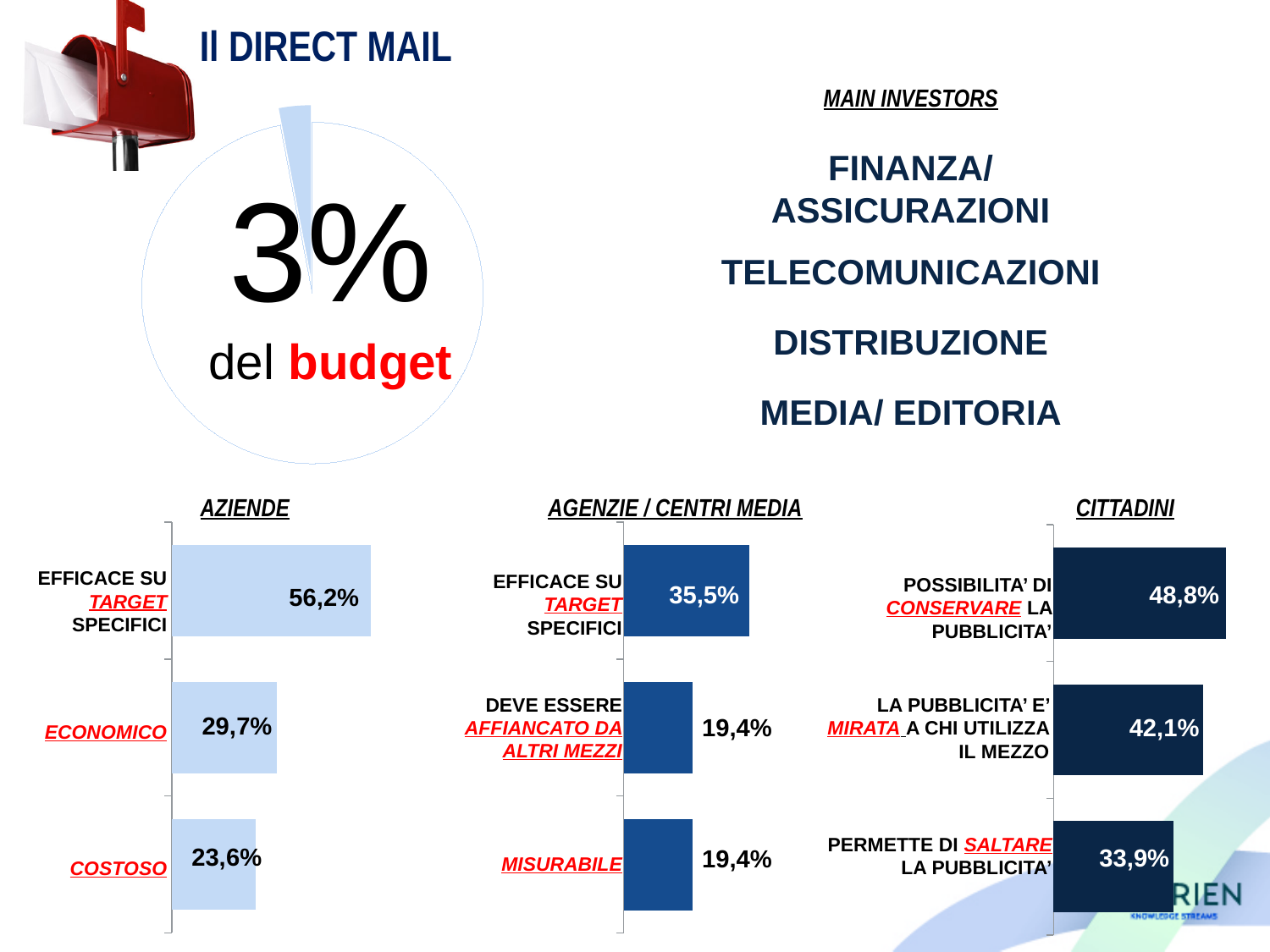
In the AGENZIE / CENTRI MEDIA chart, what is the value for MISURABILE? 19,4% In the CITTADINI chart, which category has the highest value? POSSIBILITA' DI CONSERVARE LA PUBBLICITA' In the AZIENDE chart, what is the difference between EFFICACE SU TARGET SPECIFICI and ECONOMICO? 26,5% In the AZIENDE chart, what is the value for COSTOSO? 23,6% In the CITTADINI chart, what is the value for LA PUBBLICITA' E' MIRATA A CHI UTILIZZA IL MEZZO? 42,1% In the AZIENDE chart, what is the value for EFFICACE SU TARGET SPECIFICI? 56,2% In the AZIENDE chart, which category has the lowest value? COSTOSO What kind of chart is the AGENZIE / CENTRI MEDIA chart? Bar chart What share of the budget does the pie chart at the top left show for direct mail? 3% In the CITTADINI chart, what is the difference between POSSIBILITA' DI CONSERVARE LA PUBBLICITA' and PERMETTE DI SALTARE LA PUBBLICITA'? 14,9% In the AGENZIE / CENTRI MEDIA chart, which is larger: EFFICACE SU TARGET SPECIFICI or DEVE ESSERE AFFIANCATO DA ALTRI MEZZI? EFFICACE SU TARGET SPECIFICI How many categories does the CITTADINI chart show? 3